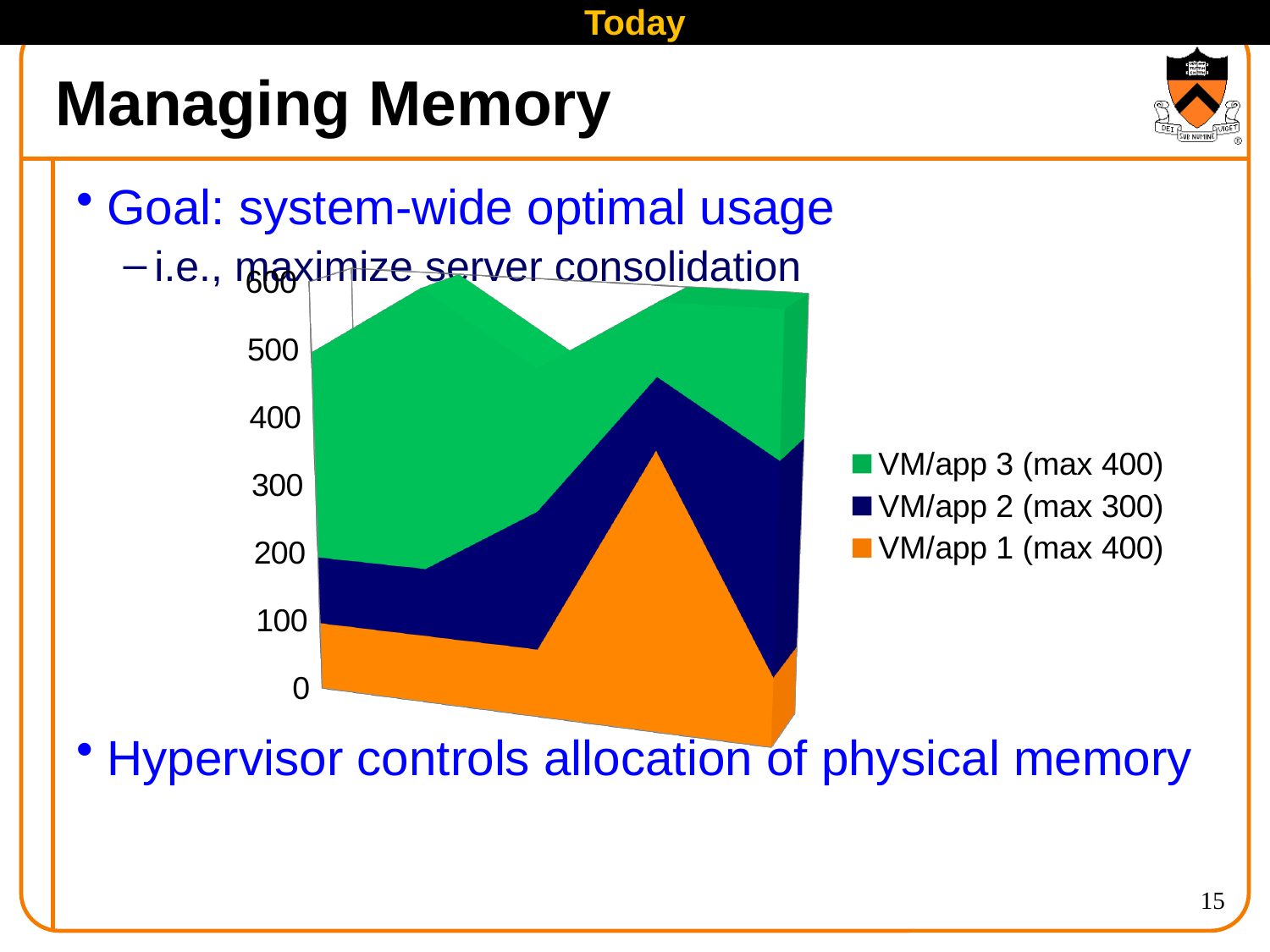
Which series is shown in green in the chart? VM/app 3 (max 400) Which series is shown in orange in the chart? VM/app 1 (max 400) What is the lowest tick value shown on the chart's vertical axis? 0 Is the highest point reached by the top of the stacked area greater or less than 400? greater Is the peak of the orange VM/app 1 area greater or less than 300? greater What is the highest tick value shown on the chart's vertical axis? 600 What kind of chart is shown on the slide? Stacked area chart How many series does the chart's legend list? 3